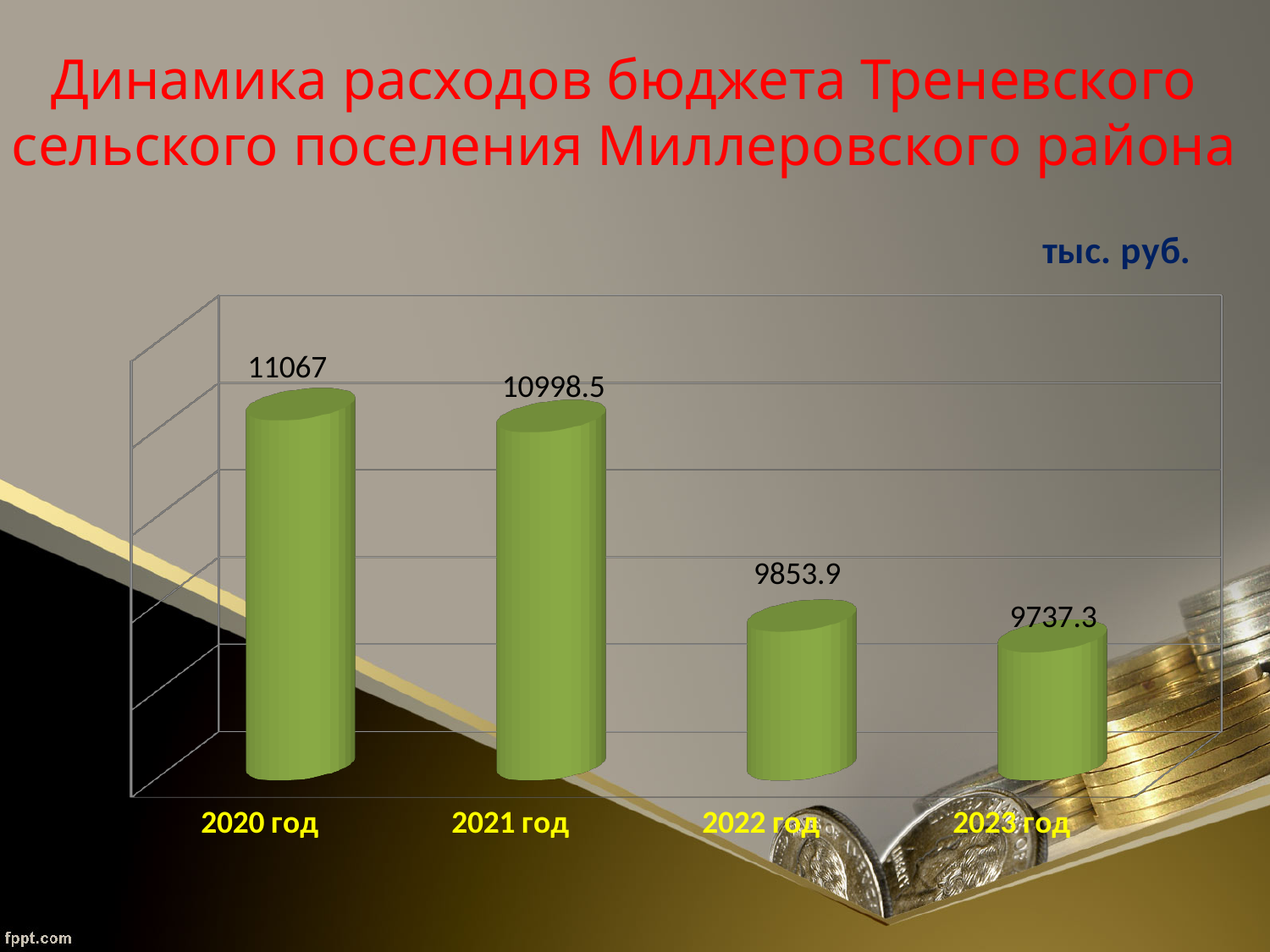
How many years are shown on the chart? 4 What is the budget expenditure value for 2022 год? 9853.9 What is the budget expenditure value for 2021 год? 10998.5 What is the difference between the values for 2020 год and 2021 год? 68.5 What kind of chart is shown on the slide? Bar chart What is the budget expenditure value for 2020 год? 11067 Which year has the highest budget expenditure? 2020 год What is the budget expenditure value for 2023 год? 9737.3 What is the difference between the values for 2022 год and 2023 год? 116.6 Which is larger, the value for 2021 год or the value for 2022 год? 2021 год Do the values rise or fall from 2020 год to 2023 год? Fall Which year has the lowest budget expenditure? 2023 год